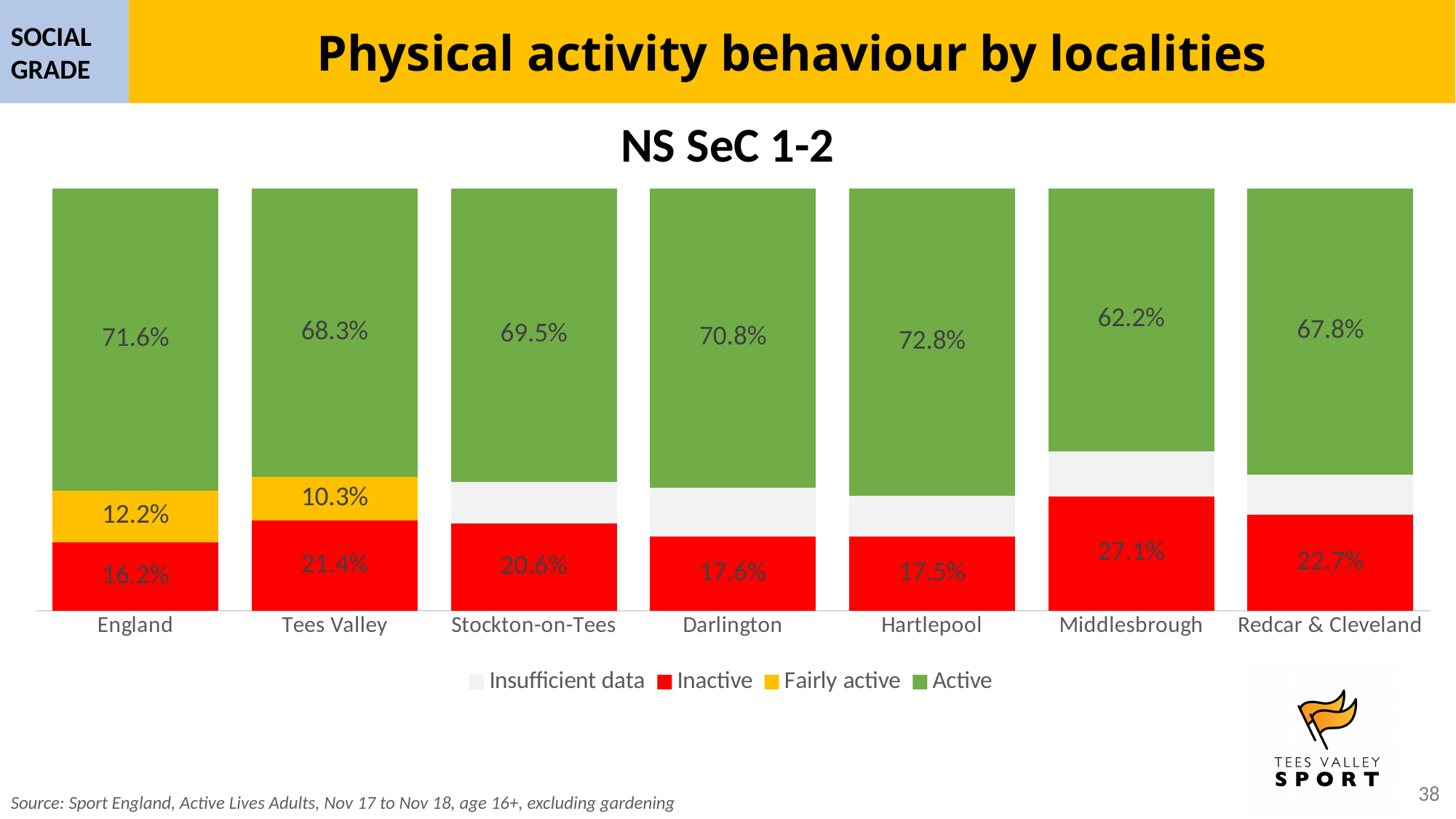
How many series does the legend list? 4 What is the difference between the Active values for Hartlepool and Middlesbrough? 10.6 percentage points Which locality has the lowest Inactive value? England Which has the larger Inactive value, Redcar & Cleveland or Stockton-on-Tees? Redcar & Cleveland What is the title of the chart? NS SeC 1-2 How many localities are shown on the x axis? 7 What kind of chart is shown? Stacked bar chart What is the Active value for Hartlepool? 72.8% Which locality has the lowest Active value? Middlesbrough What is the Fairly active value for Tees Valley? 10.3% What is the Inactive value for Middlesbrough? 27.1% Which locality has the highest Active value? Hartlepool